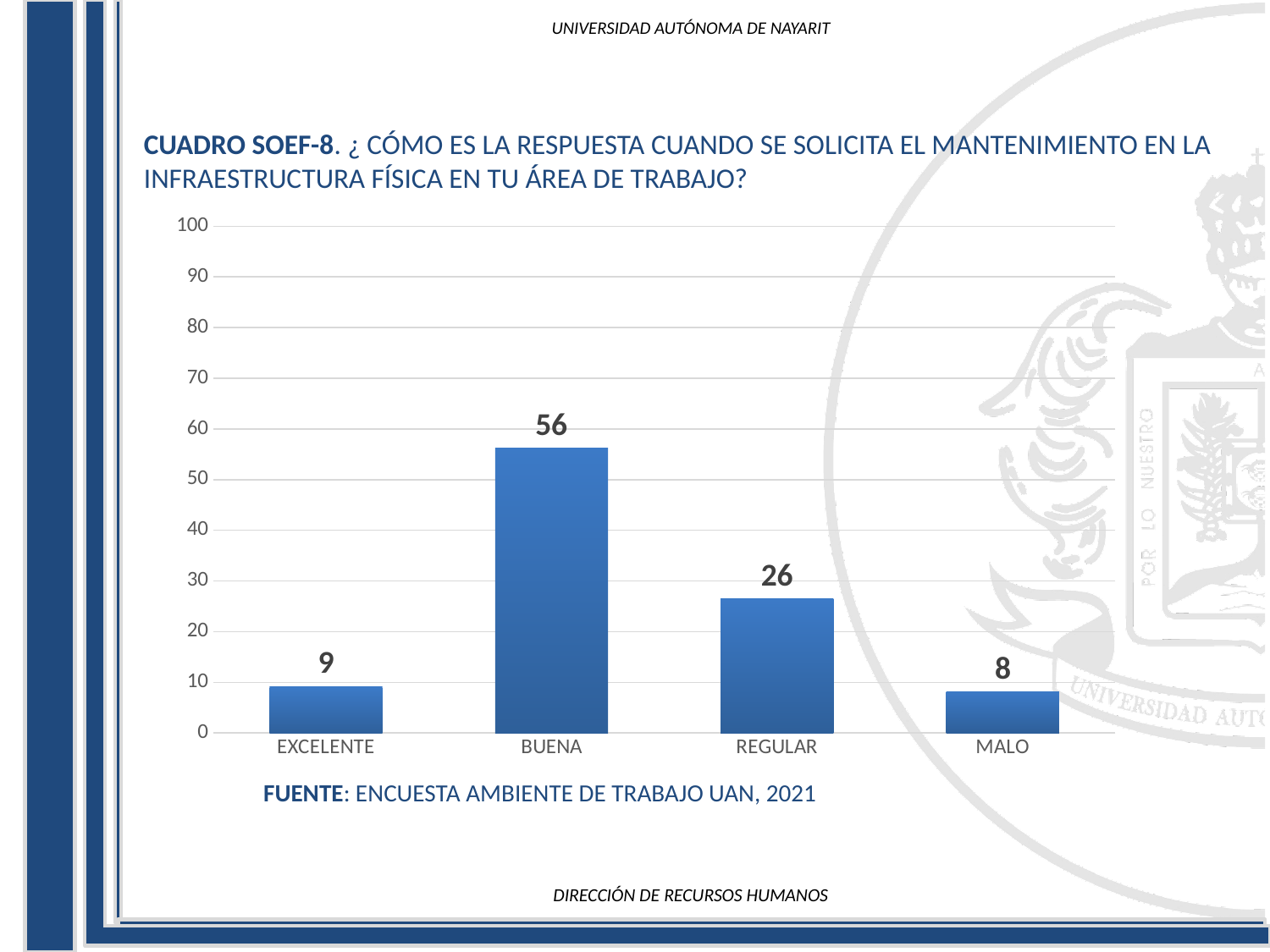
What is the value for EXCELENTE? 9 What is the value for BUENA? 56 Which is larger, the value for EXCELENTE or the value for MALO? EXCELENTE How many categories are shown on the x axis? 4 What is the value for REGULAR? 26 Which category has the highest value? BUENA What kind of chart is shown on the slide? bar chart What source is cited below the chart? ENCUESTA AMBIENTE DE TRABAJO UAN, 2021 Is the value for BUENA greater or less than 50? greater What is the value for MALO? 8 What is the total of the values for EXCELENTE and MALO? 17 What is the difference between the values for BUENA and REGULAR? 30